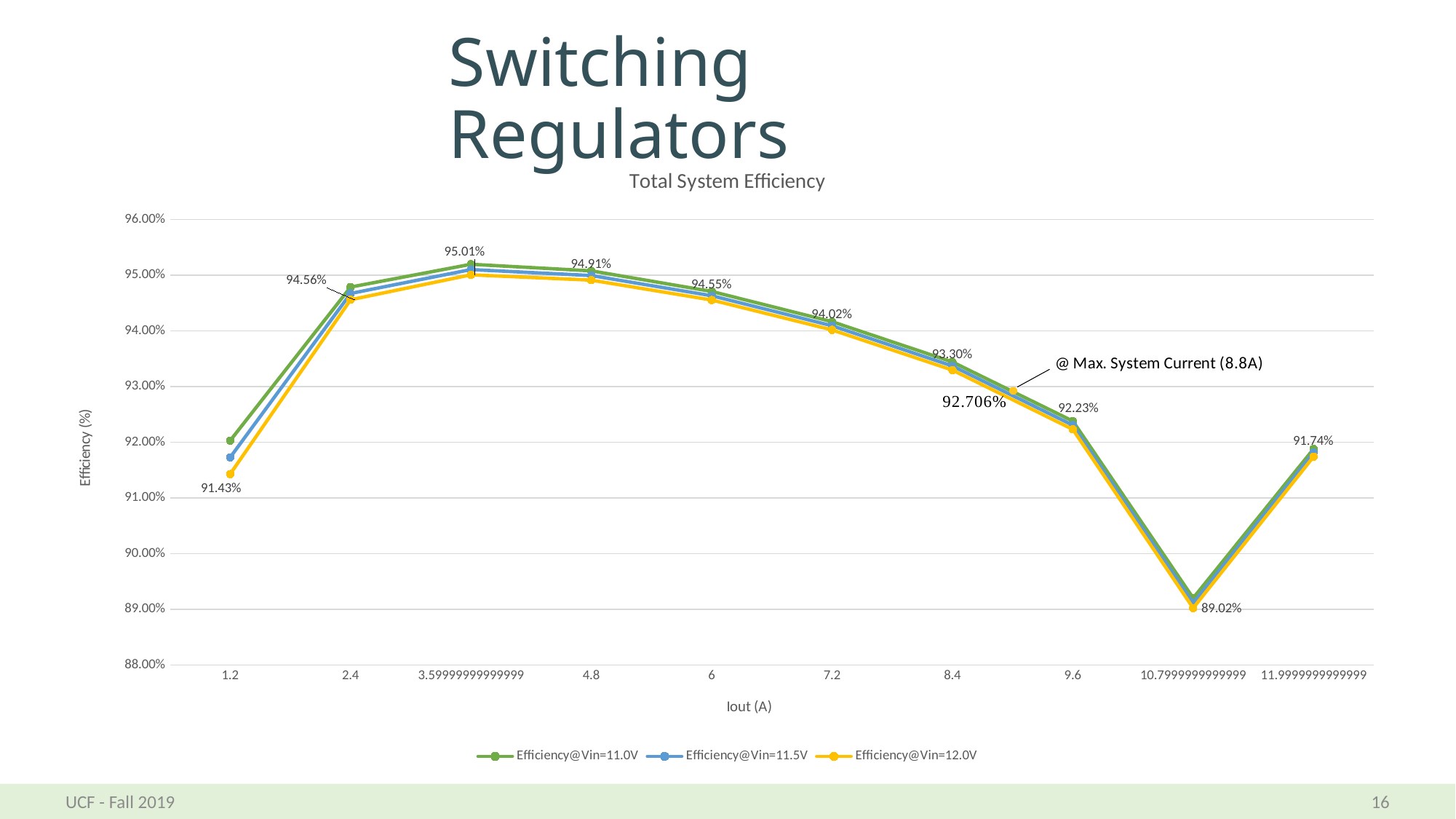
What efficiency value is labeled at Iout = 10.8 A? 89.02% What is the difference between the labeled efficiency at Iout = 3.6 A (95.01%) and at Iout = 10.8 A (89.02%)? 5.99% At which Iout value is the labeled efficiency the lowest? 10.8 How many Iout values are plotted along the x axis? 10 Is the Efficiency@Vin=11.5V value at Iout = 1.2 A greater or less than 92.00%? less Which has the higher labeled efficiency: Iout = 2.4 A or Iout = 9.6 A? 2.4 A What type of chart is shown on the slide? line chart What is the title of the chart? Total System Efficiency At which Iout value is the labeled efficiency the highest? 3.6 How many series does the chart legend list? 3 What efficiency value is labeled at Iout = 1.2 A? 91.43% What efficiency is annotated at the maximum system current of 8.8 A? 92.706%